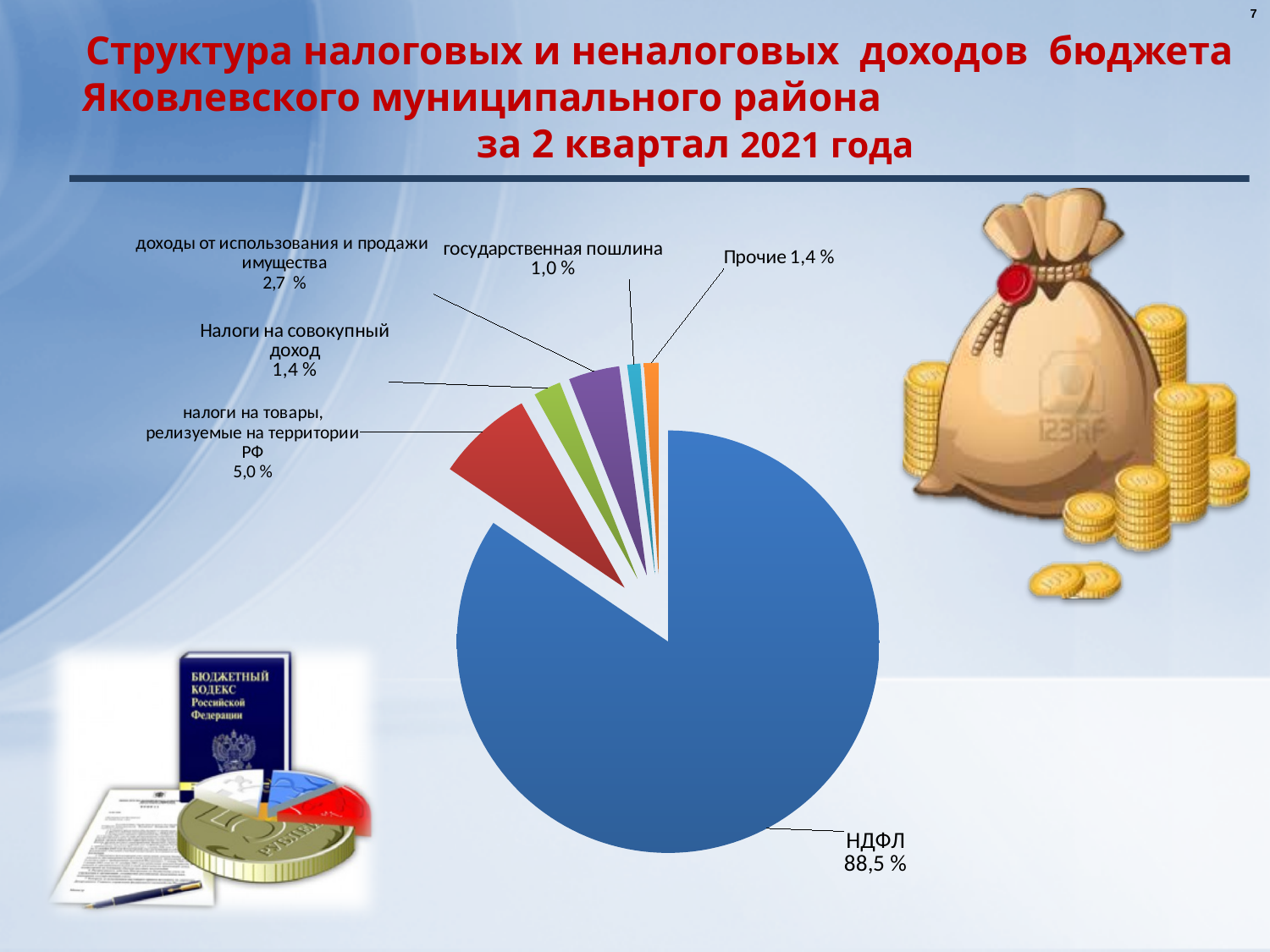
What is the value shown for Налоги на совокупный доход? 1,4 % Which is larger: налоги на товары, реализуемые на территории РФ or доходы от использования и продажи имущества? налоги на товары, реализуемые на территории РФ What is the value shown for налоги на товары, реализуемые на территории РФ? 5,0 % Which category has the largest slice of the pie? НДФЛ What share of the pie does НДФЛ account for? 88,5 % What kind of chart is shown on the slide? pie chart Which category has the smallest slice of the pie? государственная пошлина What is the difference between the share of НДФЛ and the share of налоги на товары, реализуемые на территории РФ? 83,5 % How many slices does the pie chart have? 6 What is the value shown for Прочие? 1,4 % What is the value shown for доходы от использования и продажи имущества? 2,7 % What is the value shown for государственная пошлина? 1,0 %